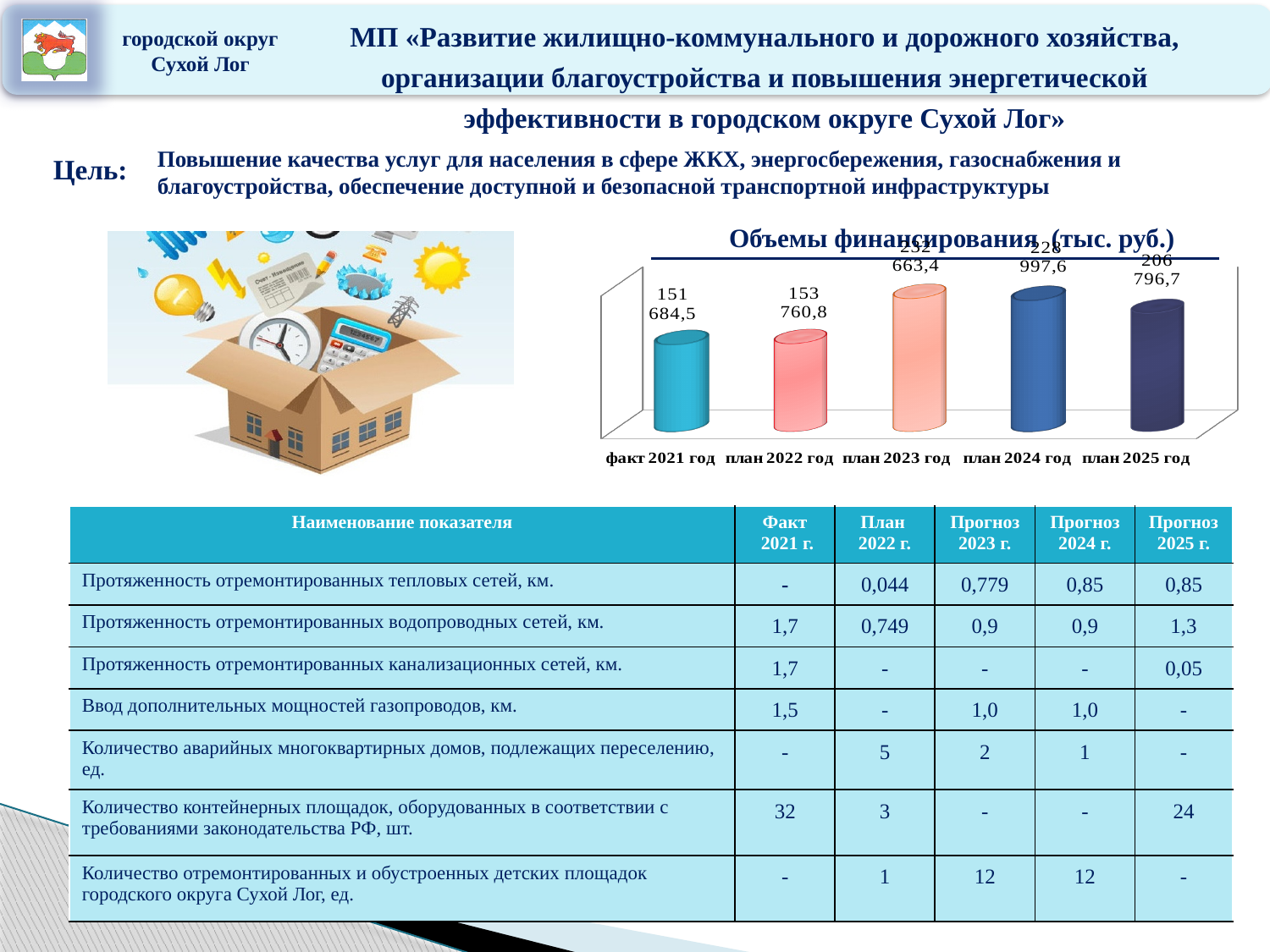
What is the financing volume for факт 2021 год? 151 684,5 In what units are the financing volumes given in the chart title? тыс. руб. What is the difference between the financing volumes for план 2025 год and факт 2021 год? 55 112,2 What type of chart is used to show the financing volumes? bar chart What is the title of the chart on the slide? Объемы финансирования (тыс. руб.) What is the financing volume for план 2022 год? 153 760,8 Which is larger: the financing volume for факт 2021 год or for план 2025 год? план 2025 год What is the financing volume for план 2025 год? 206 796,7 Which is larger: the financing volume for план 2022 год or for план 2023 год? план 2023 год What is the difference between the financing volumes for план 2022 год and факт 2021 год? 2 076,3 How many categories (years) are shown on the x axis of the financing chart? 5 Does the financing volume rise or fall from факт 2021 год to план 2023 год? rise